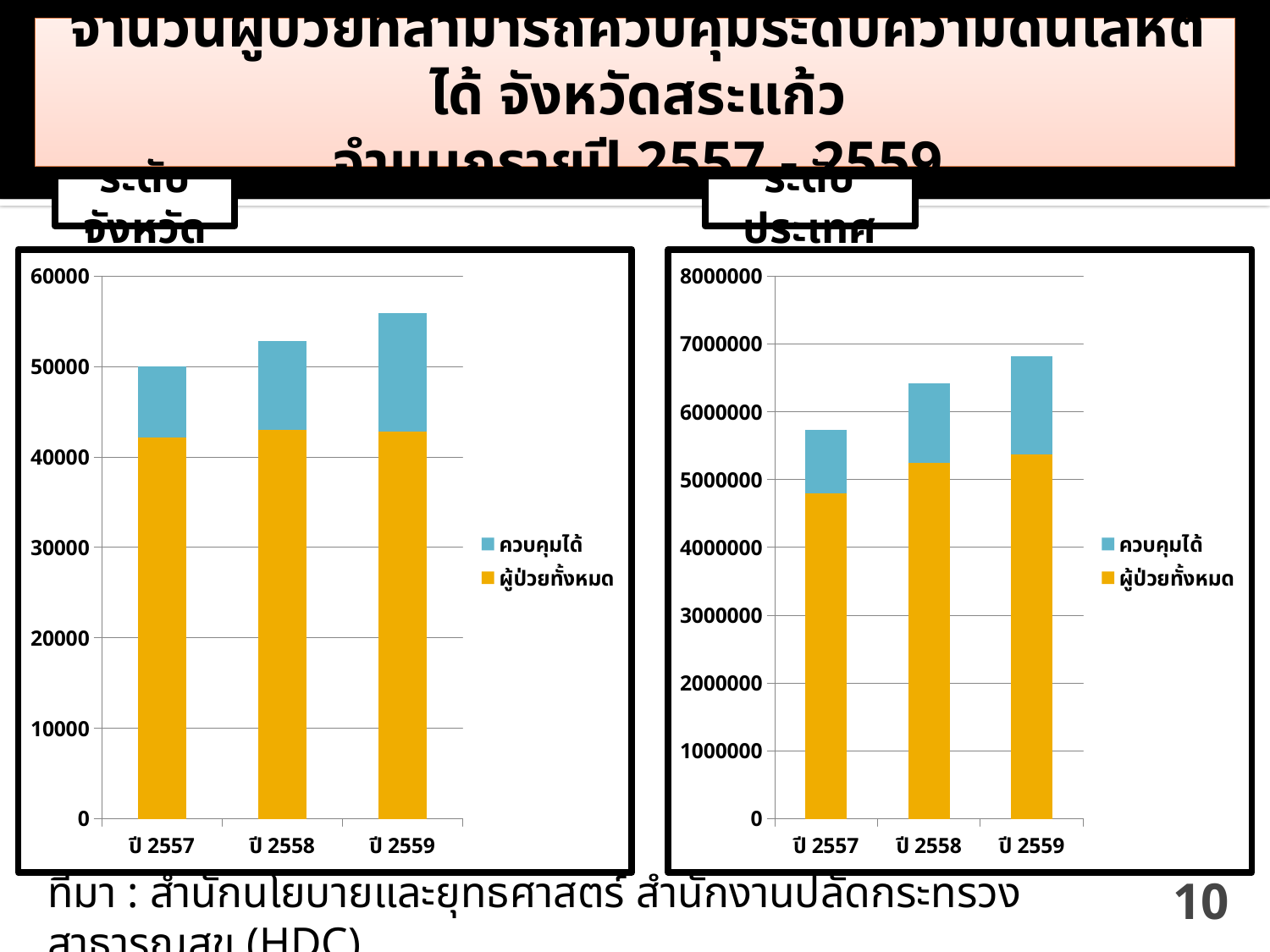
In the right chart (ระดับประเทศ), which year has the shortest stacked bar? ปี 2557 In the right chart (ระดับประเทศ), do the total stacked bar heights rise or fall from ปี 2557 to ปี 2559? rise How many years (categories) are shown on the x axis of the right chart (ระดับประเทศ)? 3 What kind of chart is the left chart (ระดับจังหวัด)? stacked bar chart In the left chart (ระดับจังหวัด), which year has the tallest stacked bar? ปี 2559 In the right chart (ระดับประเทศ), is the ผู้ป่วยทั้งหมด value for ปี 2559 greater or less than 6000000? less In the left chart (ระดับจังหวัด), which colour represents the ควบคุมได้ series? blue In the right chart (ระดับประเทศ), is the total stacked value for ปี 2557 greater or less than 5000000? greater In the left chart (ระดับจังหวัด), is the ผู้ป่วยทั้งหมด value for ปี 2559 greater or less than 50000? less How many series does the legend of the left chart (ระดับจังหวัด) list? 2 In the right chart (ระดับประเทศ), which has the larger total stacked bar, ปี 2557 or ปี 2558? ปี 2558